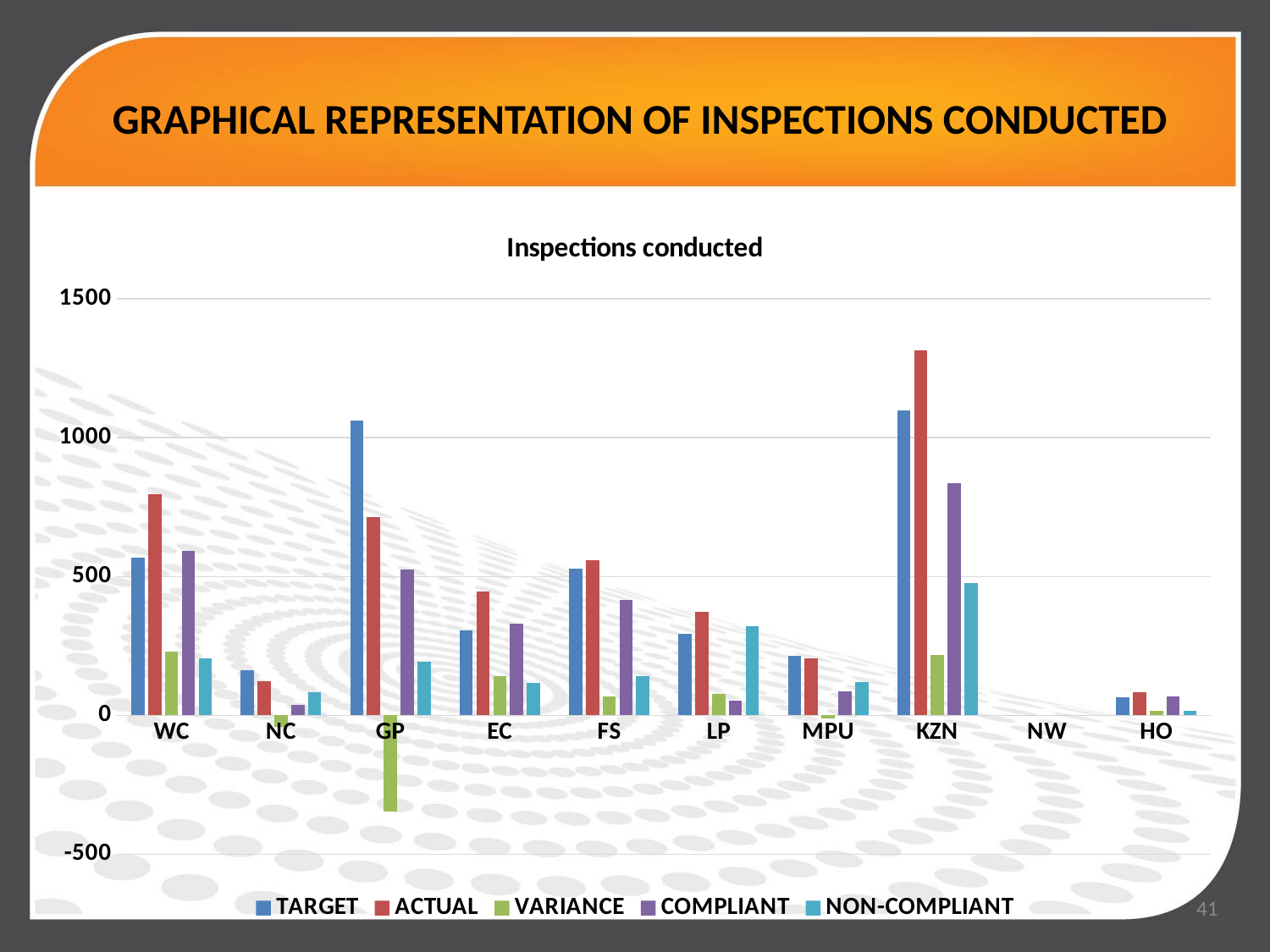
How many categories are shown on the x axis of the chart? 10 For WC, which is larger: the TARGET value or the ACTUAL value? ACTUAL For GP, which is larger: the TARGET value or the ACTUAL value? TARGET Is the VARIANCE value for GP greater or less than 0? less What kind of chart is shown on the slide? bar chart Which category has the lowest VARIANCE value? GP Is the COMPLIANT value for KZN greater or less than 500? greater Which category has the highest ACTUAL value? KZN How many series does the chart's legend list? 5 Is the ACTUAL value for KZN greater or less than 1000? greater What is the title of the chart? Inspections conducted